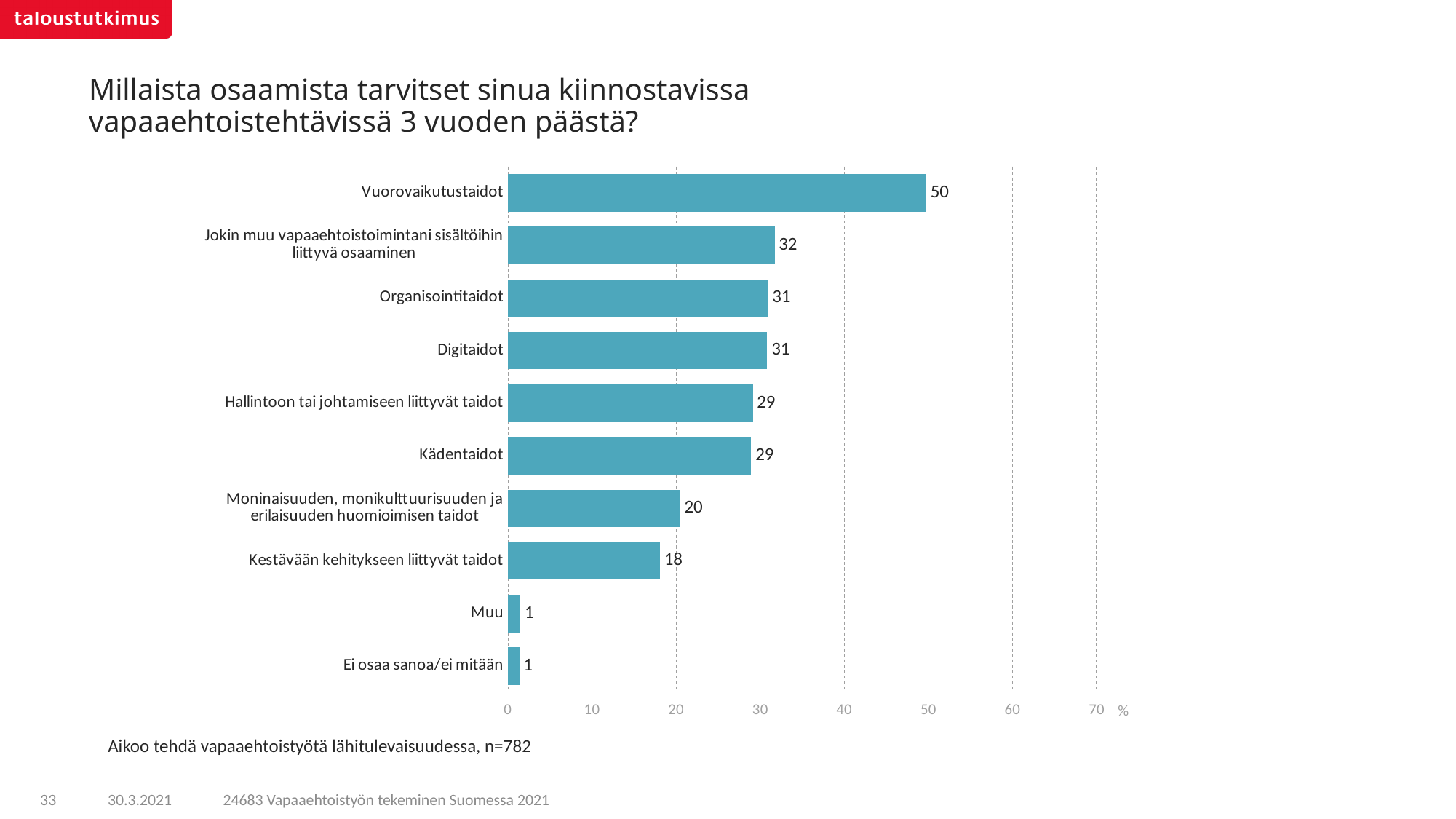
Which is larger, the value for Jokin muu vapaaehtoistoimintani sisältöihin liittyvä osaaminen or the value for Kestävään kehitykseen liittyvät taidot? Jokin muu vapaaehtoistoimintani sisältöihin liittyvä osaaminen What is the value for Digitaidot? 31 What is the sample size (n) stated below the chart? n=782 Which category has the highest value? Vuorovaikutustaidot What kind of chart is shown on the slide? bar chart What is the value for Vuorovaikutustaidot? 50 What is the difference between the values for Kädentaidot and Kestävään kehitykseen liittyvät taidot? 11 What is the value for Kestävään kehitykseen liittyvät taidot? 18 Is the value for Hallintoon tai johtamiseen liittyvät taidot greater or less than 20? greater What is the difference between the values for Vuorovaikutustaidot and Organisointitaidot? 19 What is the value for Moninaisuuden, monikulttuurisuuden ja erilaisuuden huomioimisen taidot? 20 How many categories are shown in the chart? 10